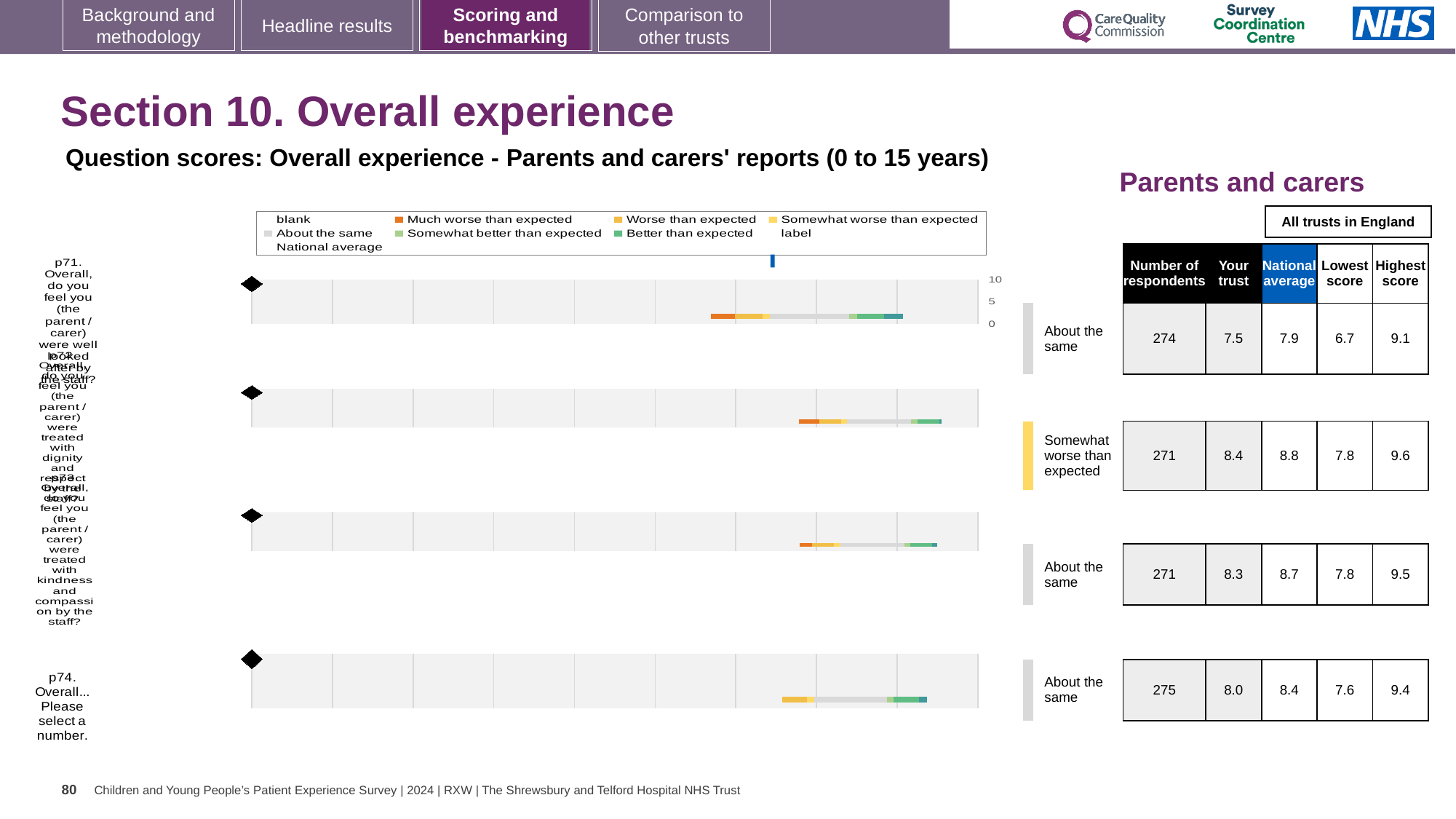
How many entries does the chart legend list? 9 Which row has the highest 'Your trust' score in the table beside the chart? second row (8.4) What kind of chart is shown on the slide? bar chart What colour does the legend use for 'Much worse than expected'? orange Which row has the lowest 'Your trust' score in the table beside the chart? p71 (7.5) How many question rows (bars) does the chart show? 4 For the bottom row (p74), which is larger: the 'Your trust' score or the national average? National average What is the national average for the bottom row (p74) in the table beside the chart? 8.4 What benchmark category label is shown next to the second row of the chart? Somewhat worse than expected How many respondents are listed for the bottom row (p74)? 275 For the top row (p71), what is the difference between the national average and the 'Your trust' score? 0.4 What is the 'Your trust' score for the top row (p71) in the table beside the chart? 7.5